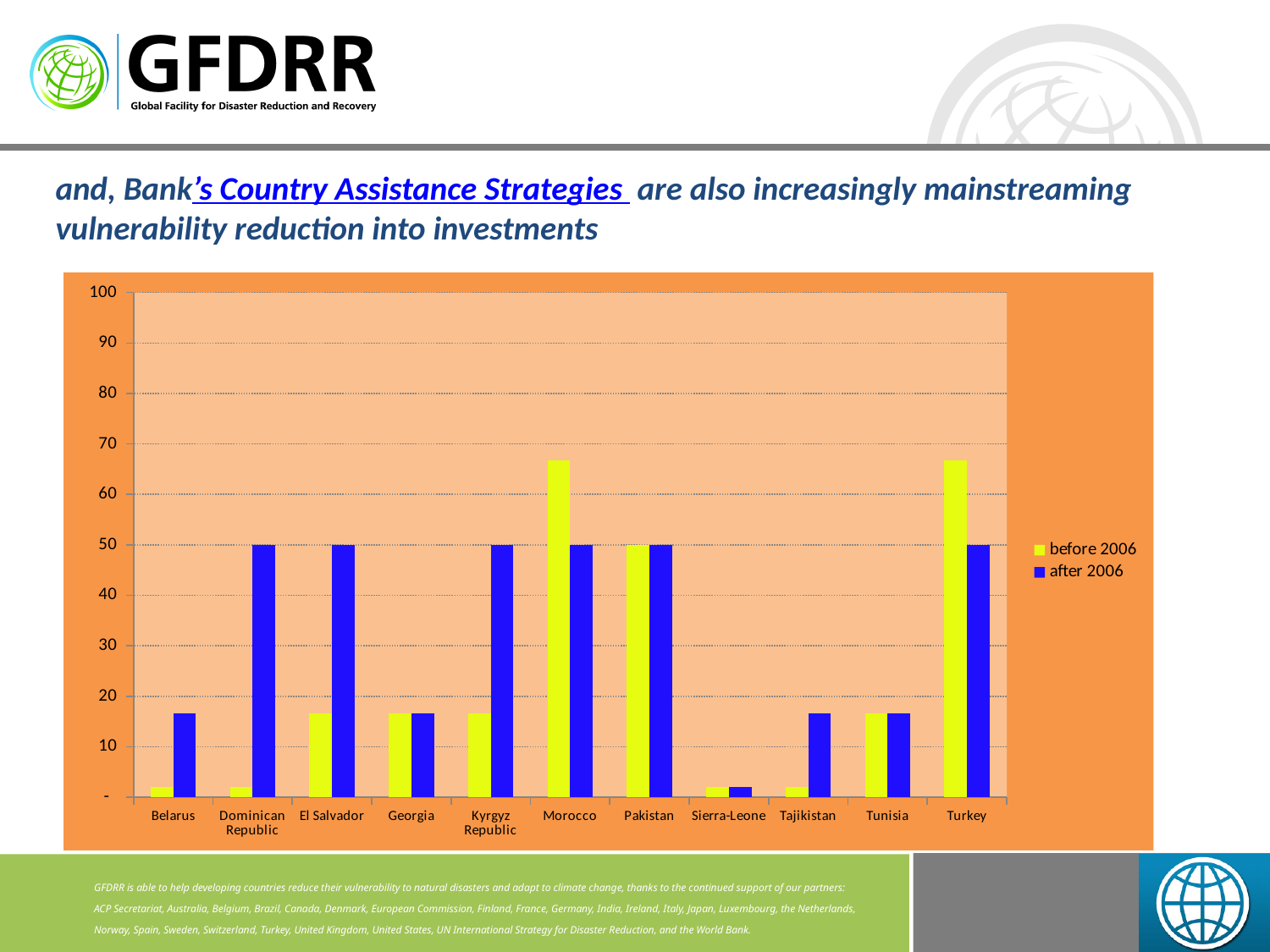
Is the value for Sierra-Leone in the 'before 2006' series greater or less than 10? less What is the value for Dominican Republic in the 'after 2006' series? 50 What kind of chart is shown on the slide? bar chart Is the value for Belarus in the 'after 2006' series greater or less than 20? less Which is larger for Turkey: the 'before 2006' value or the 'after 2006' value? before 2006 Is the value for Morocco in the 'before 2006' series greater or less than 60? greater How many series does the legend list? 2 How many countries are shown on the x axis of the chart? 11 Which is larger for El Salvador: the 'before 2006' value or the 'after 2006' value? after 2006 Which colour represents the 'after 2006' series in the chart? blue What is the value for Turkey in the 'after 2006' series? 50 What is the value for Pakistan in the 'after 2006' series? 50